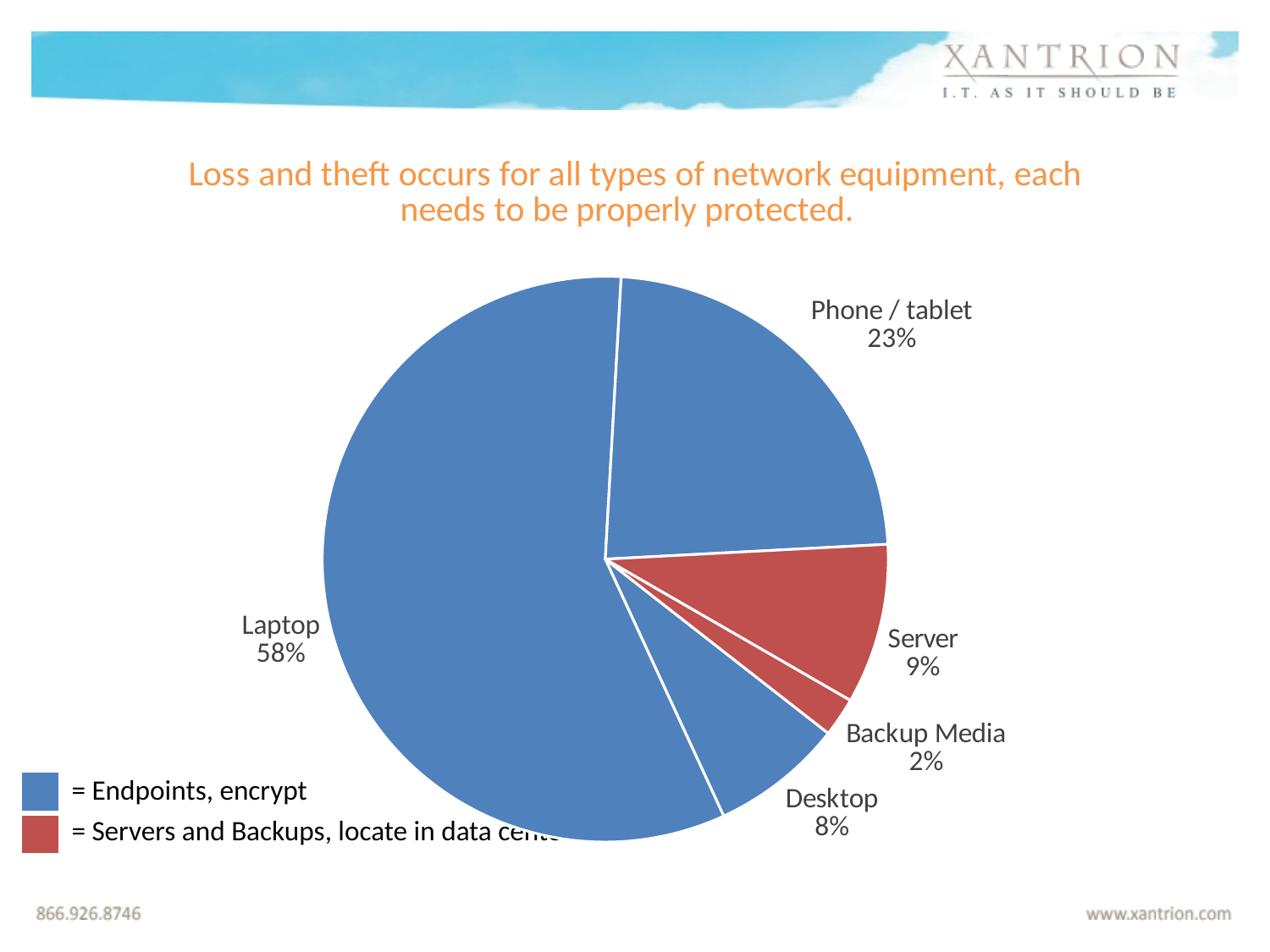
What is the value shown for Desktop? 8% What is the value shown for Server? 9% What is the value shown for Backup Media? 2% Which category has the smallest slice of the pie? Backup Media What kind of chart is shown on the slide? pie chart Which is larger, the Server slice or the Desktop slice? Server What is the value shown for Phone / tablet? 23% What is the difference between the Laptop and Phone / tablet percentages? 35% What share of the pie does Laptop account for? 58% How many categories are shown in the pie chart? 5 Which category has the largest slice of the pie? Laptop According to the legend, what do the blue slices represent? Endpoints, encrypt